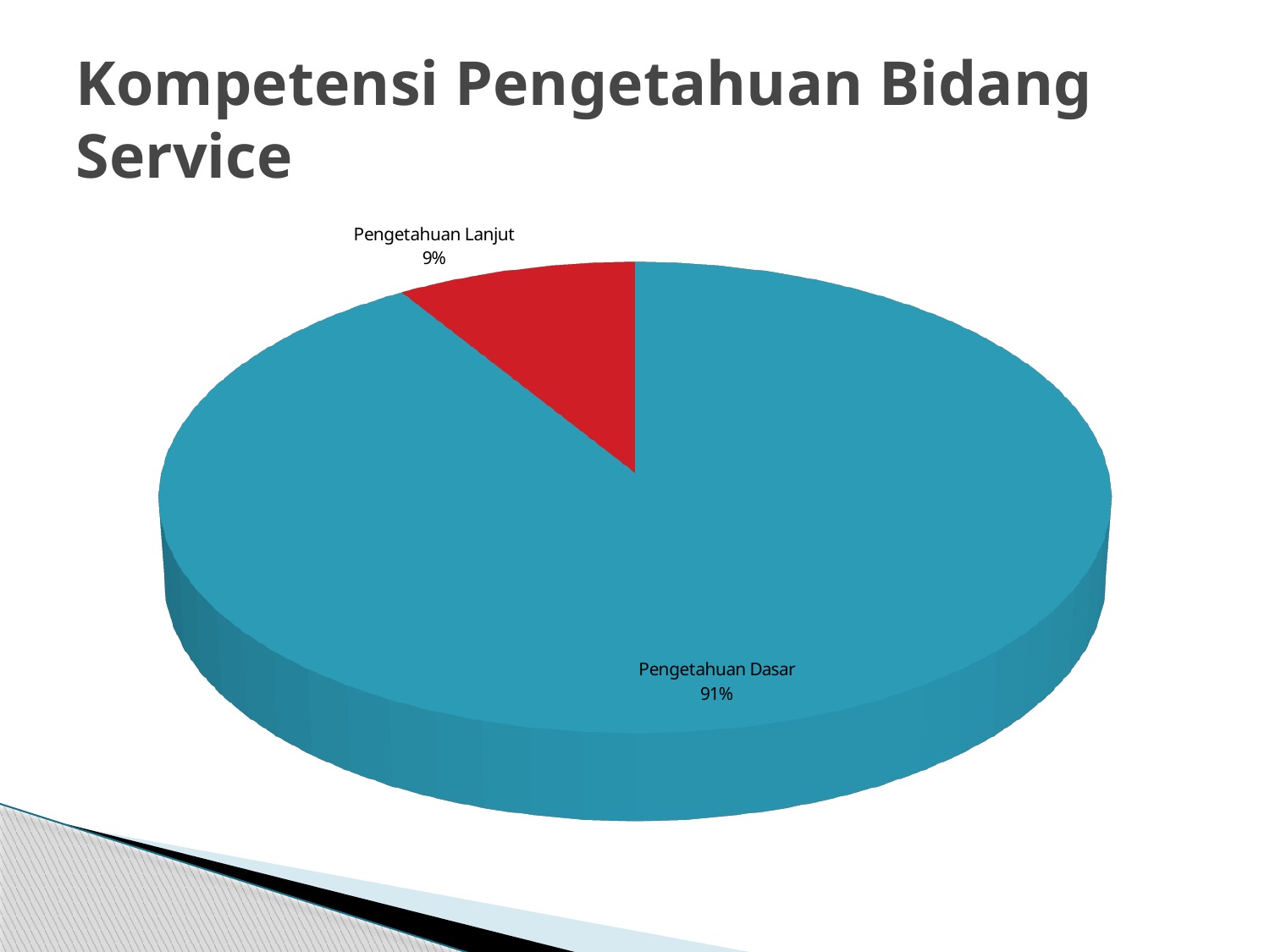
What percentage does the Pengetahuan Lanjut slice represent? 9% What kind of chart is shown on the slide? pie chart What share of the pie does Pengetahuan Lanjut take? 9% Which slice is the largest in the pie chart? Pengetahuan Dasar Which slice is the smallest in the pie chart? Pengetahuan Lanjut Which is larger, Pengetahuan Dasar or Pengetahuan Lanjut? Pengetahuan Dasar What percentage does the Pengetahuan Dasar slice represent? 91% How many slices does the pie chart have? 2 What is the title of the slide containing the pie chart? Kompetensi Pengetahuan Bidang Service What colour is the Pengetahuan Lanjut slice? red What is the difference in percentage points between Pengetahuan Dasar and Pengetahuan Lanjut? 82